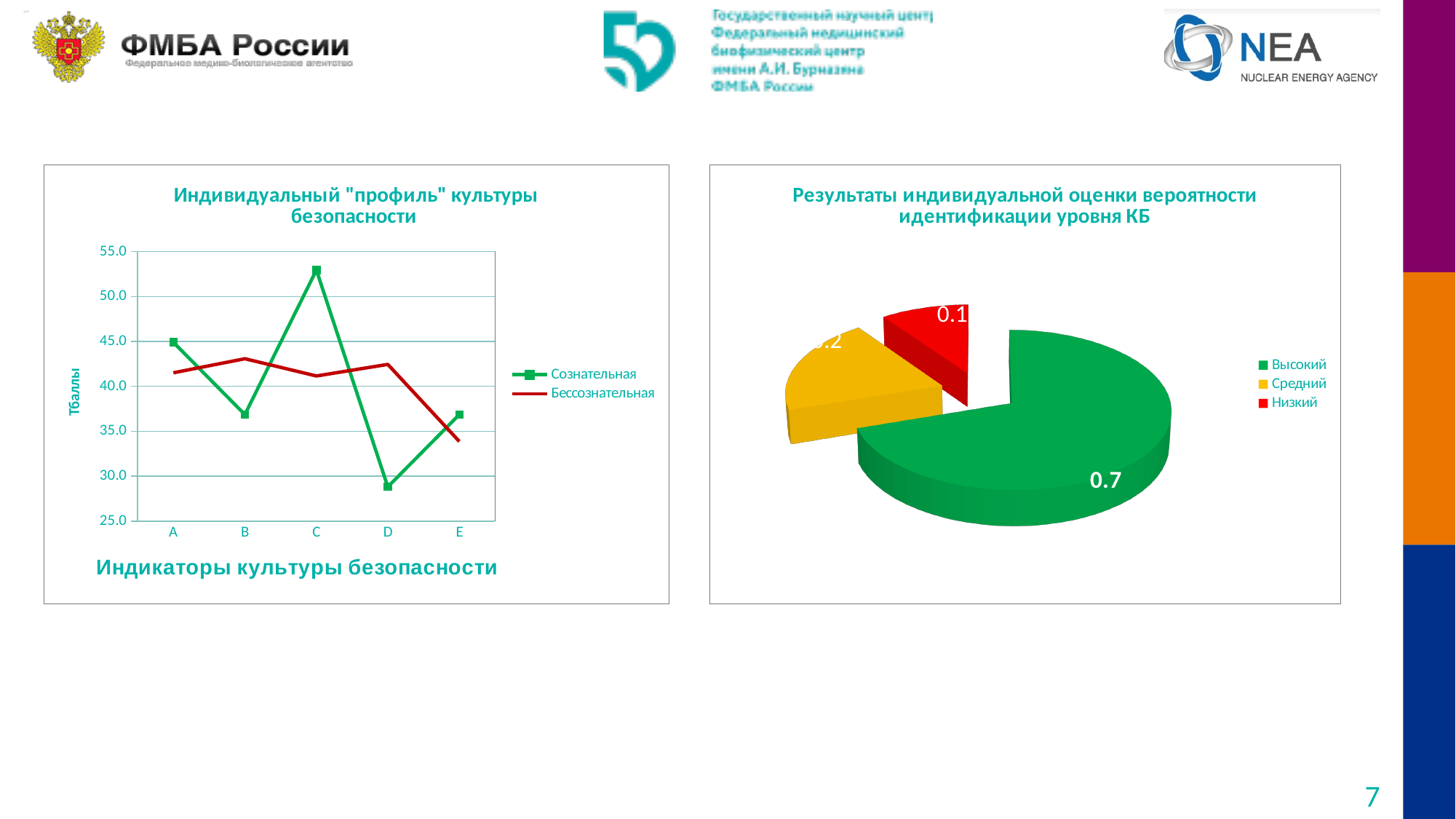
In the left line chart, at which category does the Сознательная series reach its lowest value? D In the right pie chart, what value is shown for the Высокий slice? 0.7 In the left line chart, how many categories are shown on the x axis? 5 In the right pie chart, what value is shown for the Низкий slice? 0.1 What kind of chart is the right chart titled "Результаты индивидуальной оценки вероятности идентификации уровня КБ"? pie chart What kind of chart is the left chart titled "Индивидуальный "профиль" культуры безопасности"? line chart In the left line chart, is the Сознательная value at D greater or less than 30.0? less In the right pie chart, which category has the largest slice? Высокий In the left line chart, how many series does the legend list? 2 In the left line chart, at category C, which series has the larger value, Сознательная or Бессознательная? Сознательная In the left line chart, at which category does the Сознательная series reach its highest value? C In the left line chart, is the Сознательная value at C greater or less than 50.0? greater